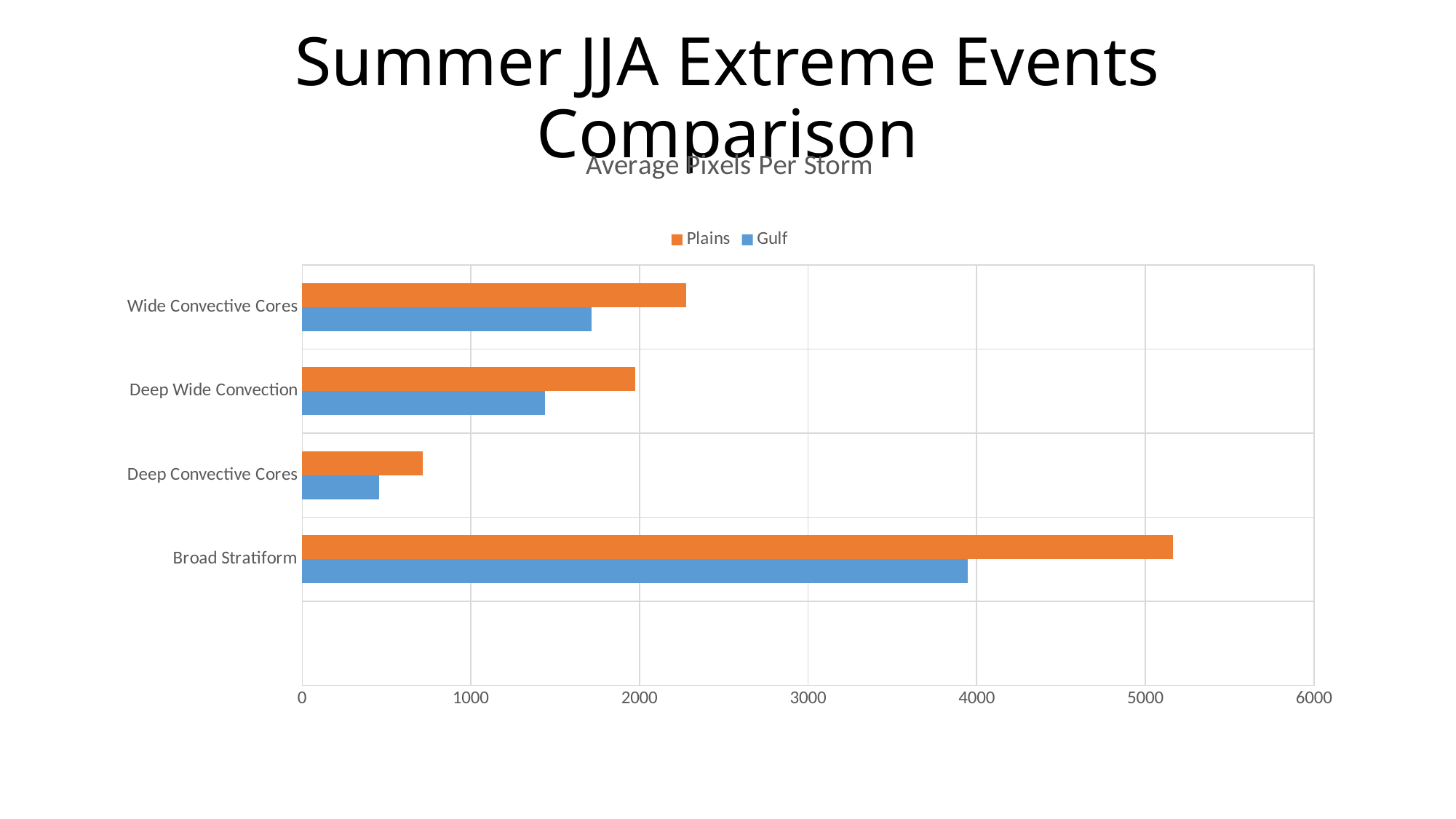
Which category has the highest Plains value? Broad Stratiform How many categories are shown on the chart? 4 Is the Plains value for Deep Convective Cores greater or less than 1000? less Which colour represents the Gulf series? blue What is the title of the chart? Average Pixels Per Storm For Deep Wide Convection, which series has the larger value, Plains or Gulf? Plains How many series does the legend list? 2 Which category has the lowest Gulf value? Deep Convective Cores What kind of chart is shown on the slide? bar chart Is the Gulf value for Broad Stratiform greater or less than 3000? greater Is the Plains value for Broad Stratiform greater or less than 5000? greater